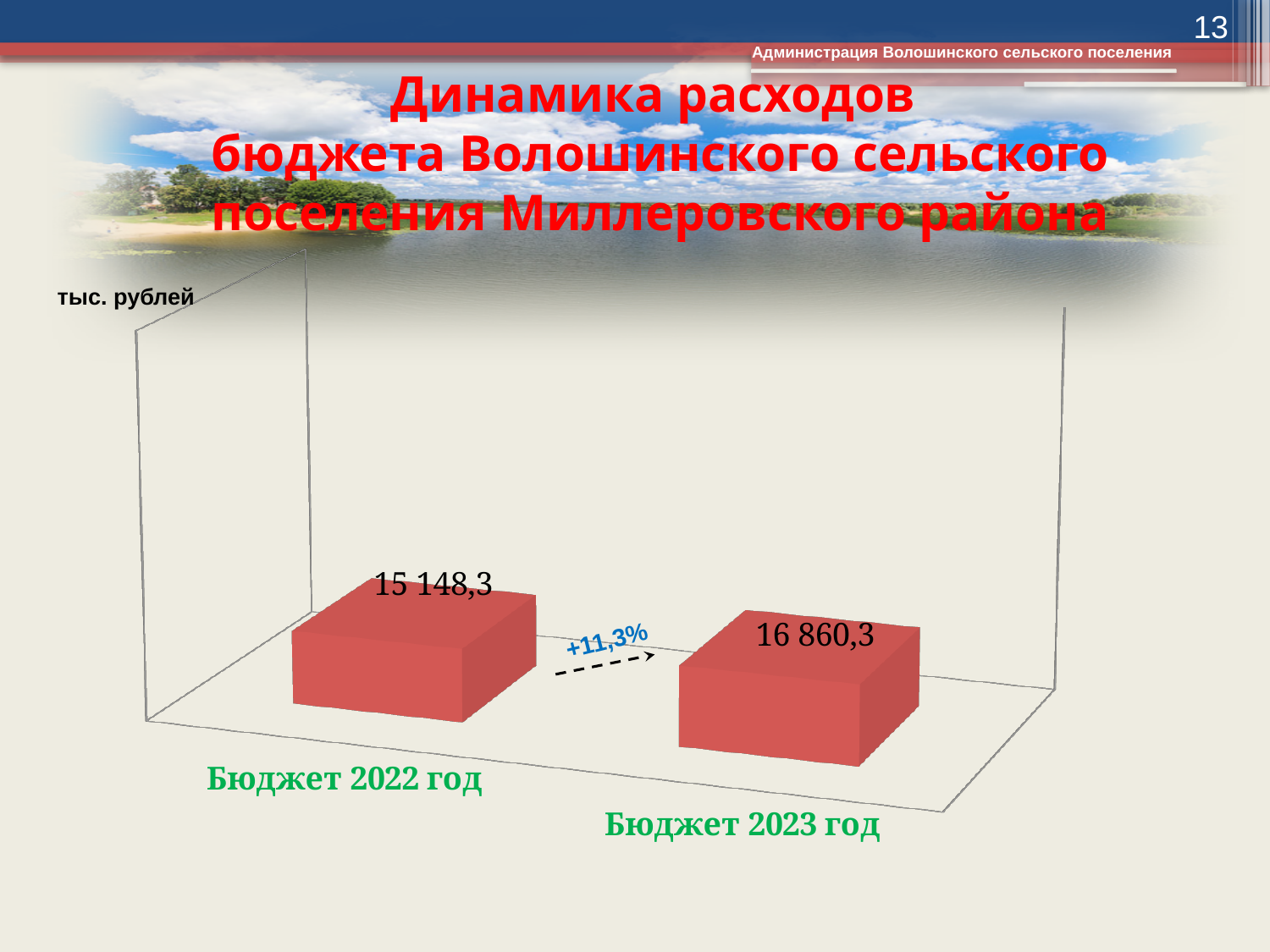
How many categories are plotted in the chart? 2 Which category has the lowest value? Бюджет 2022 год Which is larger, the value for Бюджет 2022 год or the value for Бюджет 2023 год? Бюджет 2023 год What percentage change is annotated between the two bars? +11,3% What unit of measurement is indicated on the chart? тыс. рублей Do the values rise or fall from Бюджет 2022 год to Бюджет 2023 год? Rise What kind of chart is shown on the slide? Bar chart What is the difference between the values for Бюджет 2023 год and Бюджет 2022 год? 1 712,0 What is the value shown for Бюджет 2022 год? 15 148,3 Which category has the highest value? Бюджет 2023 год What is the value shown for Бюджет 2023 год? 16 860,3